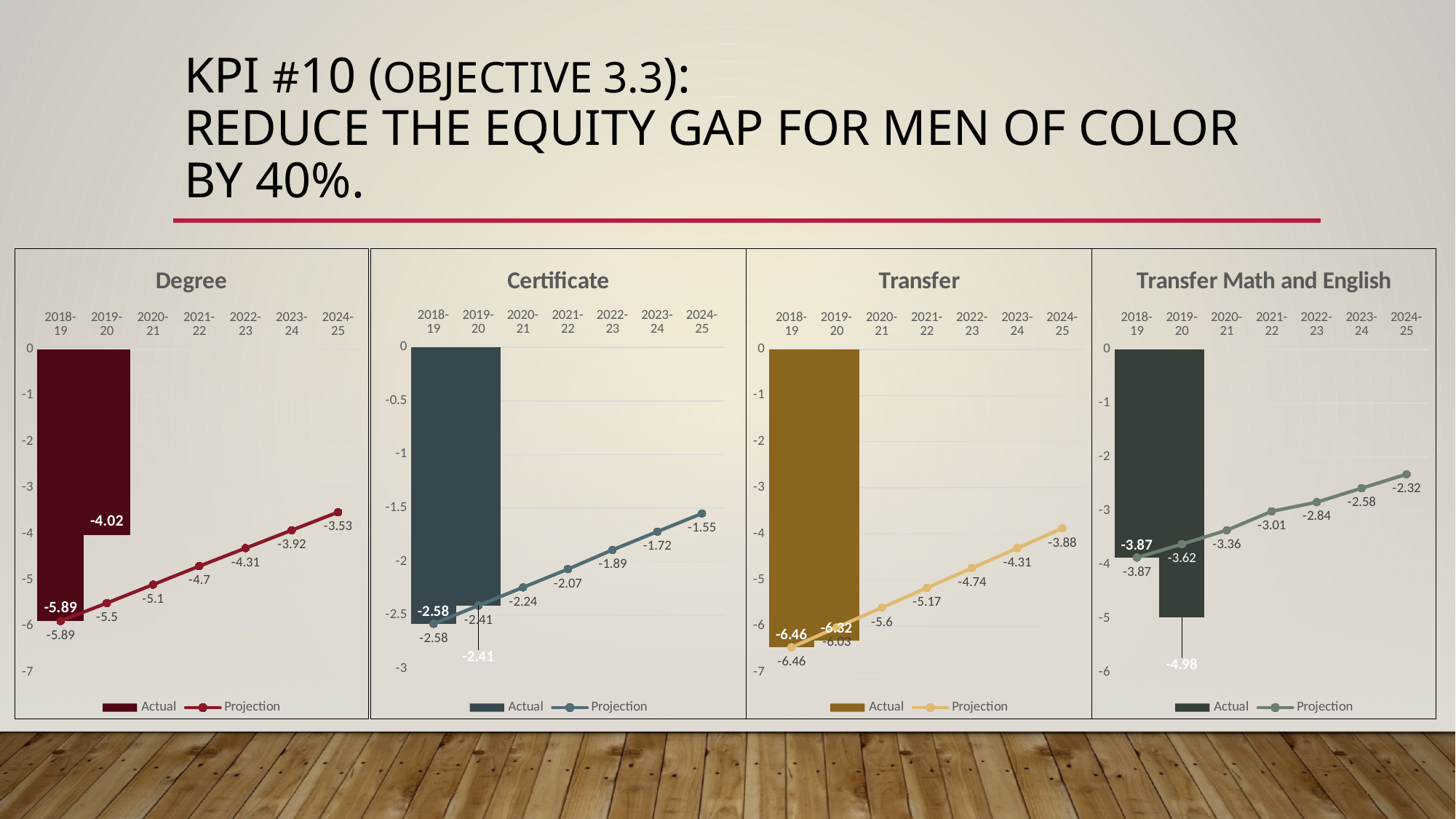
How many years are shown on the x axis of the Transfer chart? 7 In the Transfer Math and English chart, what is the Actual value for 2019-20? -4.98 In the Transfer chart, what is the Actual value for 2018-19? -6.46 In the Certificate chart, is the Actual value for 2018-19 or 2019-20 larger? 2019-20 In the Degree chart, what is the difference between the Projection values for 2018-19 and 2024-25? 2.36 In the Transfer Math and English chart, which year has the lowest Actual value? 2019-20 In the Degree chart, what is the Actual value for 2019-20? -4.02 In the Transfer chart, what is the Projection value for 2021-22? -5.17 In the Certificate chart, what is the Projection value for 2024-25? -1.55 What are the two series named in the legend of the Transfer Math and English chart? Actual and Projection In the Certificate chart, does the Projection line rise or fall from 2018-19 to 2024-25? rise How many series does the legend of the Degree chart list? 2